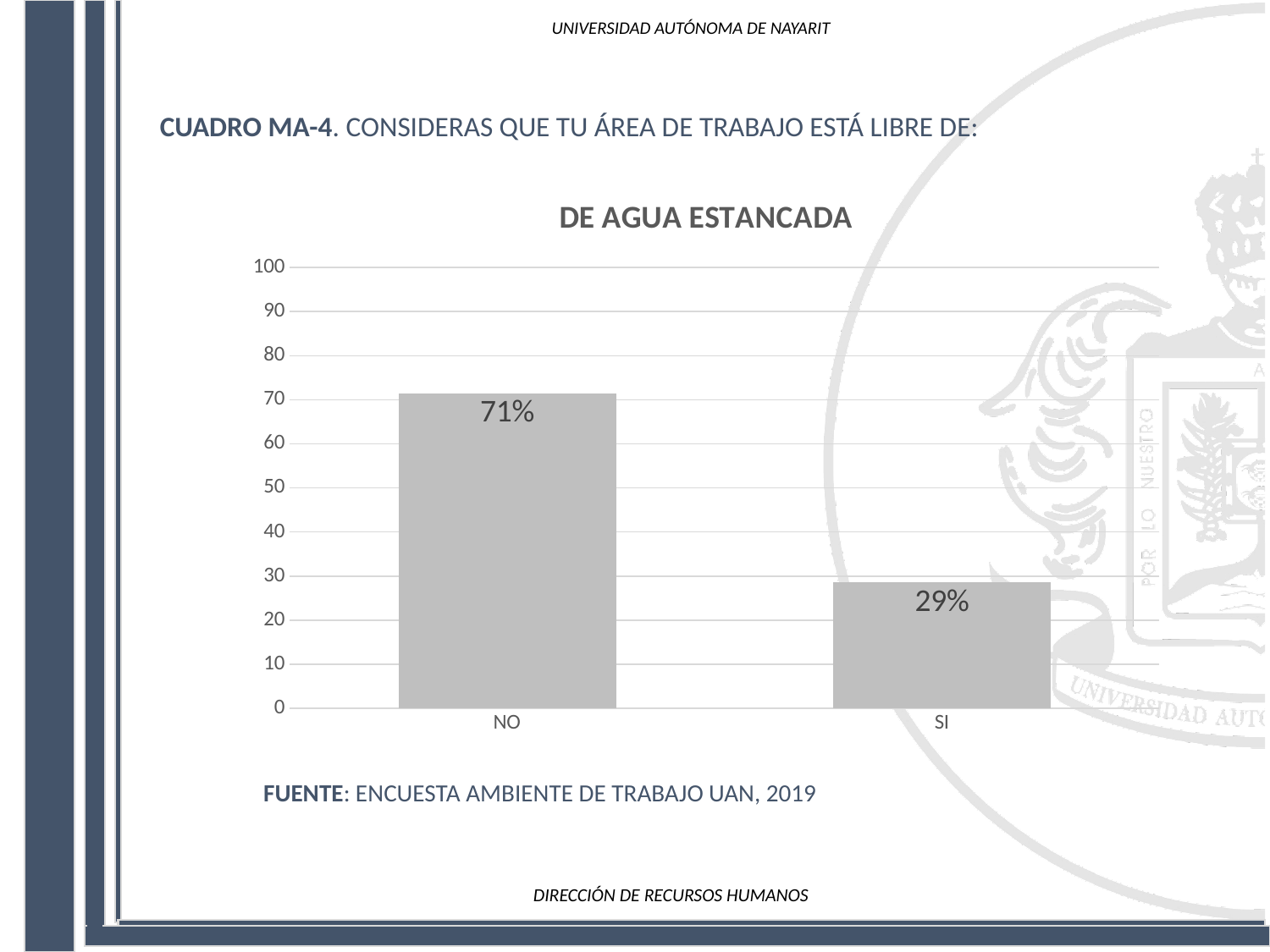
What kind of chart is shown? bar chart Which is larger, the value for NO or the value for SI? NO What is the value for SI? 29% What is the title of the chart? DE AGUA ESTANCADA What is the highest value shown on the y axis? 100 Which category has the highest value? NO What is the value for NO? 71% Is the value for SI greater or less than 40? less Which category has the lowest value? SI What is the difference between the values for NO and SI? 42% How many categories are shown on the x axis? 2 Is the value for NO greater or less than 60? greater